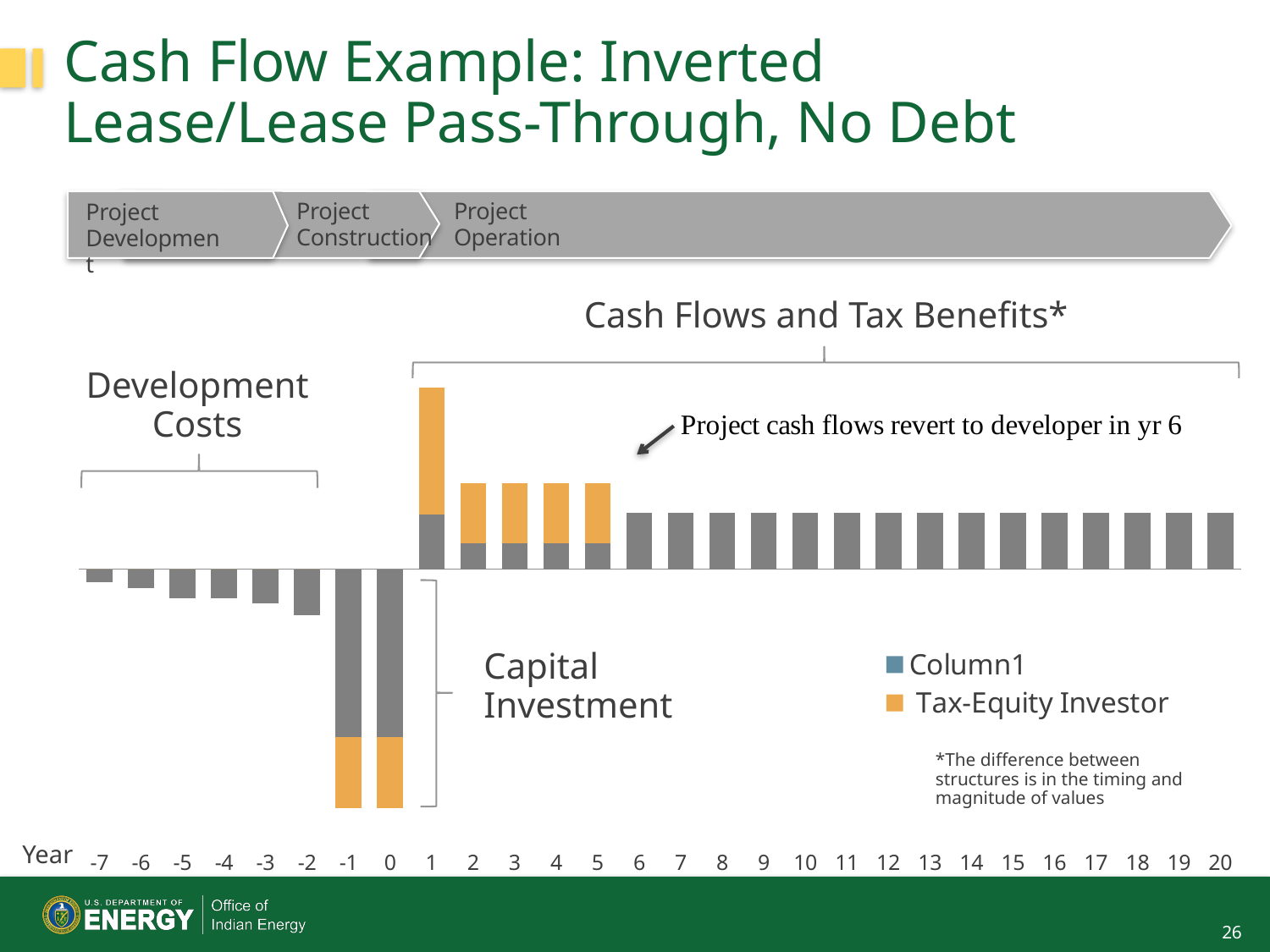
Is the Tax-Equity Investor portion of the bar in year 1 larger or smaller than in year 2? Larger How many year categories are shown along the x axis? 28 What are the two entries in the chart legend? Column1 and Tax-Equity Investor Which year has the tallest positive bar? Year 1 How many years show a positive Tax-Equity Investor (orange) portion above the axis? 5 What is the title of the chart? Cash Flows and Tax Benefits* Is the total bar height in year 5 larger or smaller than in year 6? Larger Do the negative development cost bars from year -7 to year -2 grow or shrink in size? Grow According to the annotation on the chart, in which year do project cash flows revert to the developer? Year 6 What kind of chart is shown on the slide? Stacked bar chart How many series does the chart legend list? 2 How many years have bars extending below the axis? 8